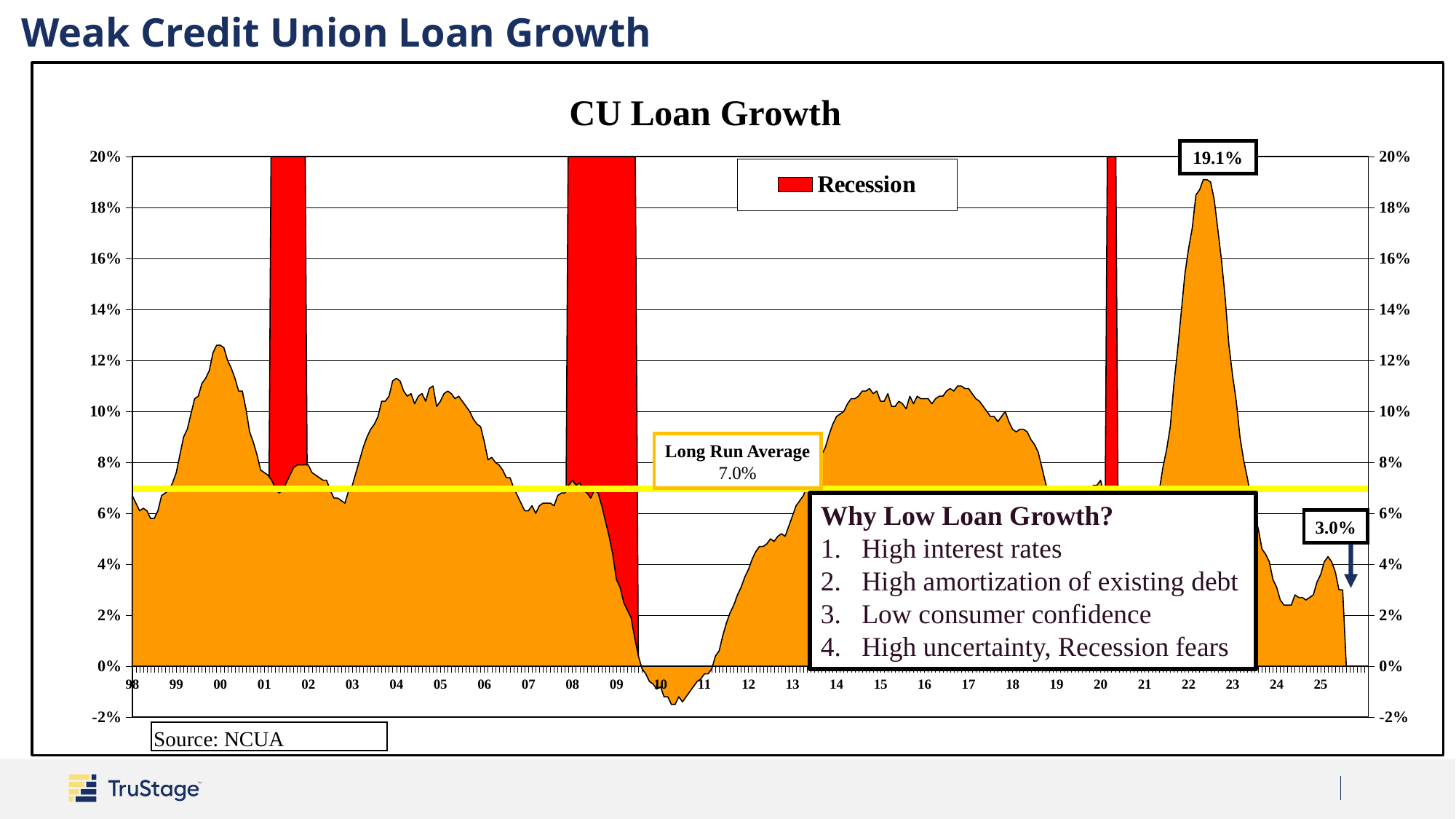
How many recession periods are shaded on the chart? 3 What is the peak value labeled on the chart around 2022? 19.1% Does loan growth rise or fall from the 2022 peak to 2025? Fall What is the title of the chart? CU Loan Growth Which is larger: the loan growth peak around 2022 or the peak around 2000? The peak around 2022 Is the loan growth value at the trough around 2010 greater or less than 0%? less What kind of chart is shown on the slide? Area chart What is the most recent value labeled on the chart in 2025? 3.0% Is the loan growth value in 2016 greater or less than 8%? greater How much higher is the labeled 19.1% peak than the Long Run Average of 7.0%? 12.1% What is the Long Run Average value shown on the chart? 7.0% What is the difference between the labeled 2022 peak of 19.1% and the labeled 2025 value of 3.0%? 16.1%